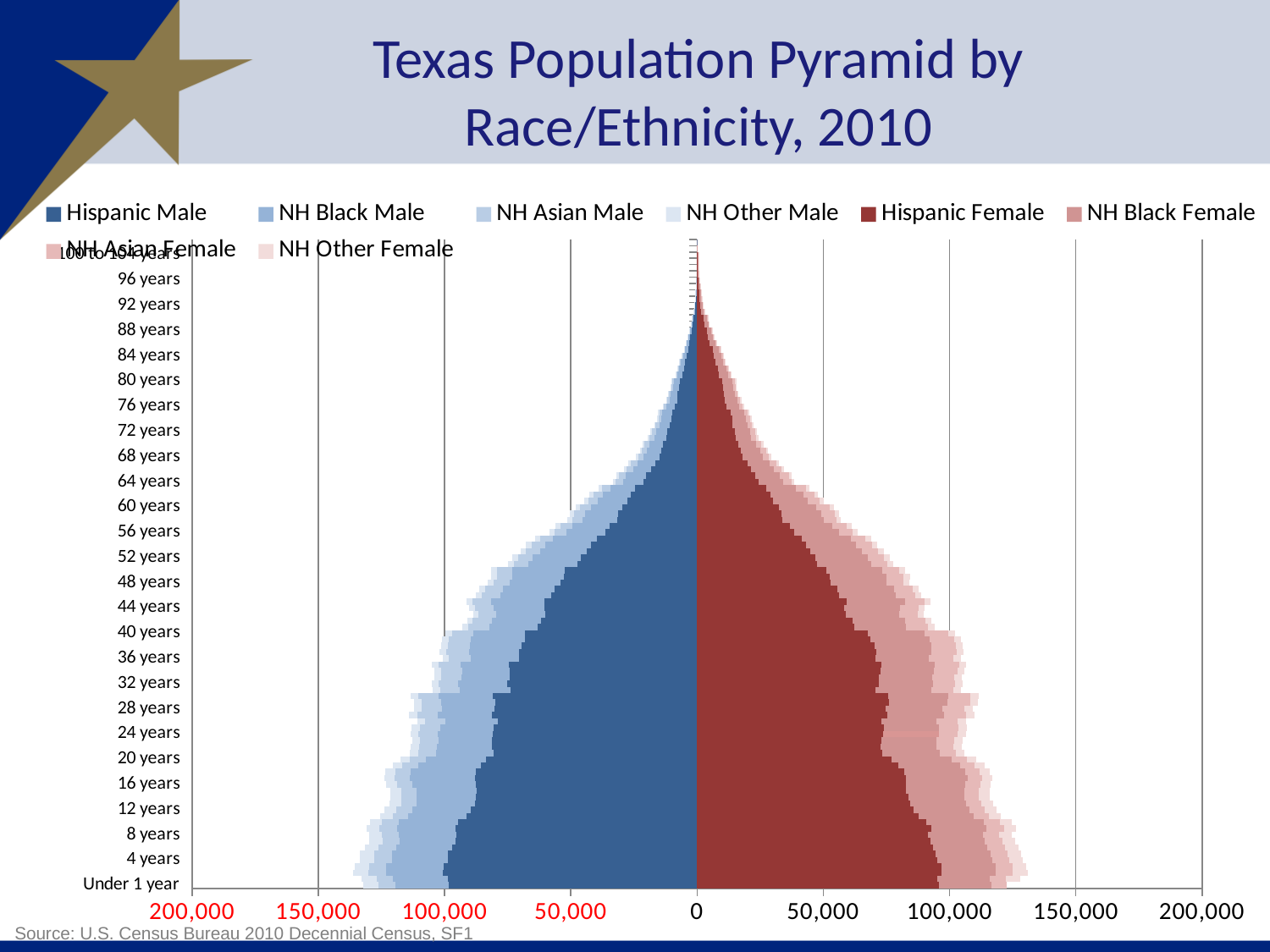
Is the Hispanic Male value for Under 1 year greater or less than 50,000? greater Is the total female population (all series combined) for 88 years greater or less than 50,000? less Which is larger, the Hispanic Male value for Under 1 year or the Hispanic Male value for 76 years? Under 1 year How many series does the legend list? 8 Is the Hispanic Male value for 80 years greater or less than 50,000? less Do the Hispanic Male values generally rise or fall as age increases from 40 years to 100 to 104 years? fall What is the title of the chart? Texas Population Pyramid by Race/Ethnicity, 2010 What kind of chart is shown on the slide? bar chart Which series is shown in the darkest blue on the left side of the pyramid? Hispanic Male